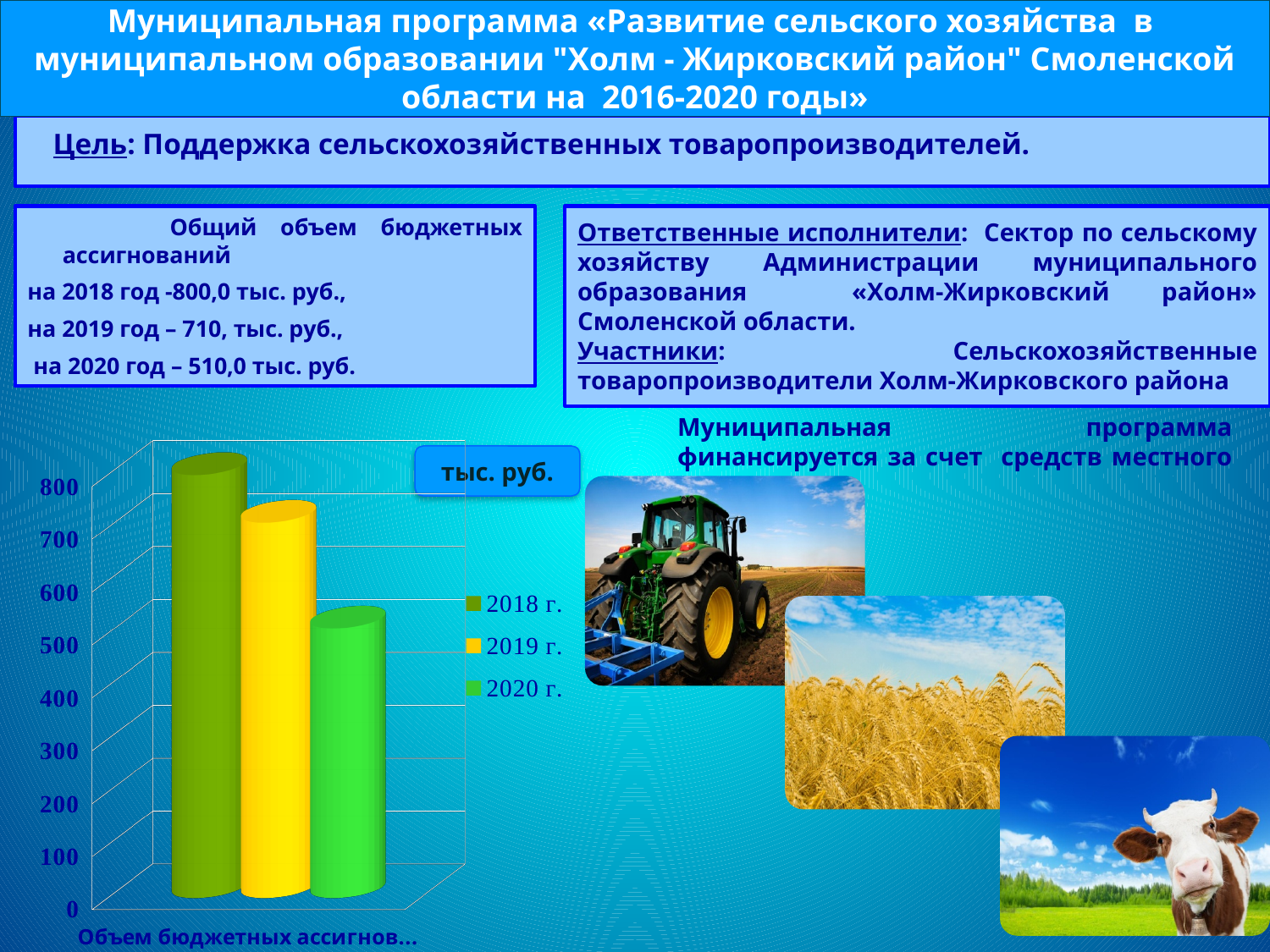
What kind of chart is shown on the slide? bar chart What is the budget allocation for 2018 shown in the chart? 800,0 тыс. руб. What is the difference between the 2018 and 2020 budget allocations? 290 тыс. руб. How many series does the chart legend list? 3 What is the budget allocation for 2020 shown in the chart? 510,0 тыс. руб. Which year has the highest bar in the chart? 2018 г. Is the value for 2019 г. greater or less than 800? less What unit is shown in the box above the chart? тыс. руб. Which is larger, the value for 2019 г. or the value for 2020 г.? 2019 г. Do the bar values rise or fall from 2018 to 2020? fall Is the value for 2020 г. greater or less than 600? less Which year has the lowest bar in the chart? 2020 г.